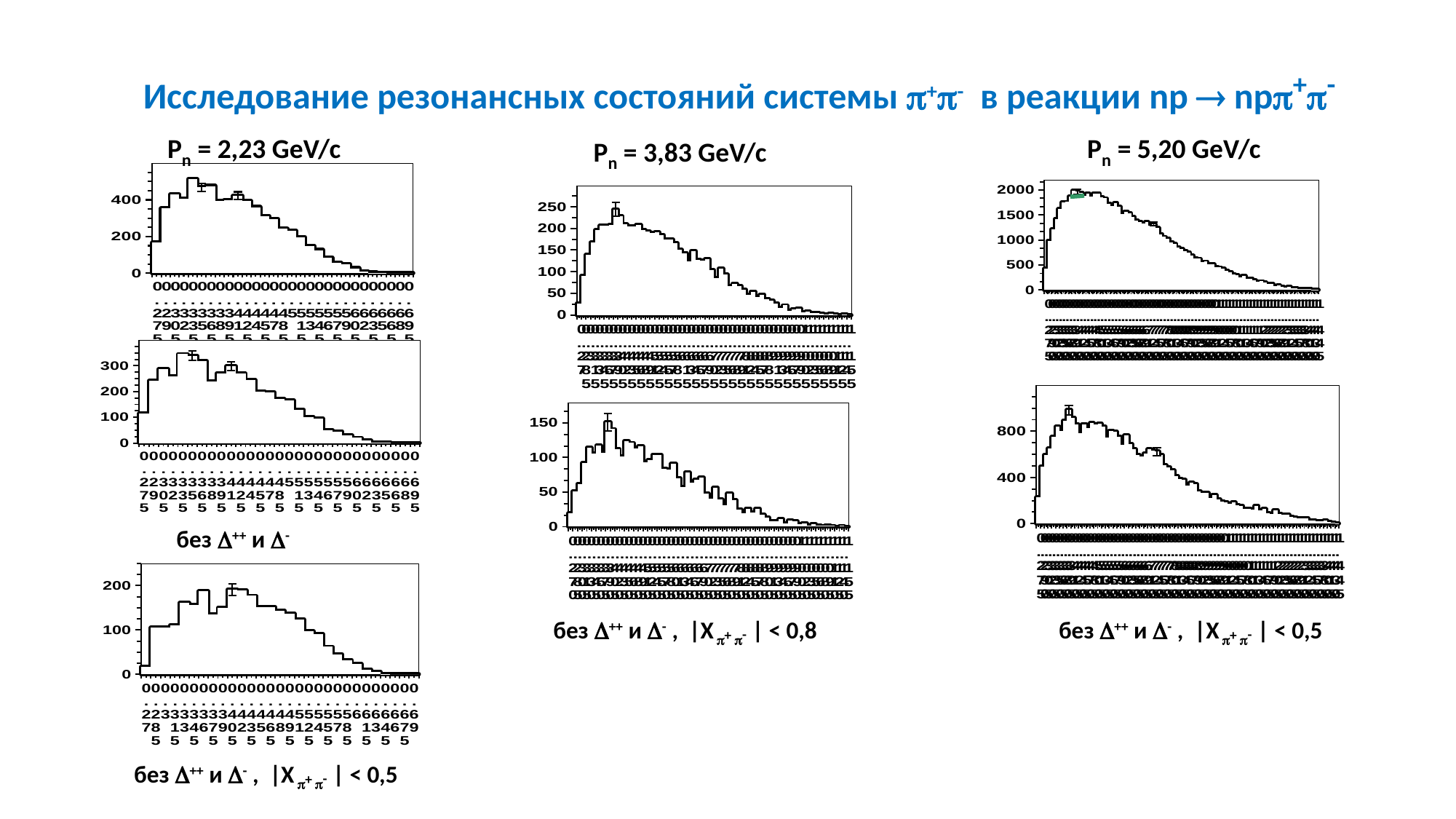
In the middle-left chart (second chart under P_n = 2,23 GeV/c), is the peak value greater or less than 300? greater In the bottom chart under P_n = 3,83 GeV/c, is the peak value greater or less than 100? greater What neutron momentum P_n is given above the middle column of charts? 3,83 GeV/c What is the highest y-axis tick label on the top chart under P_n = 5,20 GeV/c? 2000 Which chart has the higher peak: the top-left chart or the middle-left chart under P_n = 2,23 GeV/c? top-left chart In the top chart under P_n = 5,20 GeV/c, do the values rise or fall along the x axis after the peak? fall In the bottom chart under P_n = 5,20 GeV/c, is the peak value greater or less than 800? greater What kind of chart is the top-left chart under P_n = 2,23 GeV/c? histogram How many charts are shown on the slide? 7